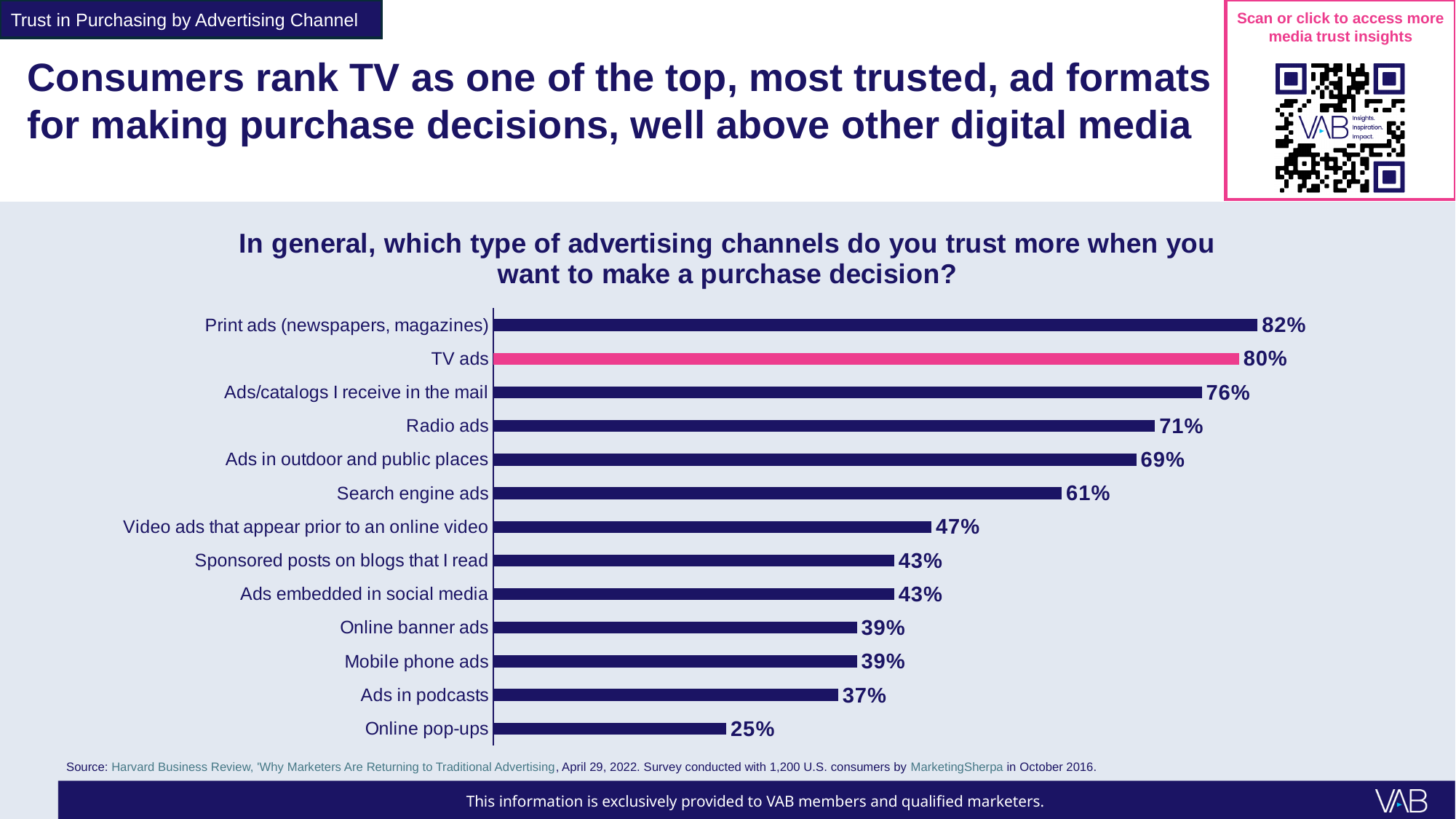
How many advertising channels are shown in the chart? 13 What is the difference between the values for TV ads and Online pop-ups? 55% What is the value shown for Search engine ads? 61% Which has a higher value: Ads/catalogs I receive in the mail or Ads in outdoor and public places? Ads/catalogs I receive in the mail What percentage of consumers trust TV ads more when making a purchase decision? 80% What is the value shown for Radio ads? 71% Which advertising channel has the highest trust value in the chart? Print ads (newspapers, magazines) What type of chart is used on this slide? Bar chart Which has a higher value: Video ads that appear prior to an online video or Ads in podcasts? Video ads that appear prior to an online video Which bar in the chart is highlighted in pink rather than dark blue? TV ads What is the difference between the values for Print ads (newspapers, magazines) and TV ads? 2% Which advertising channel has the lowest trust value in the chart? Online pop-ups